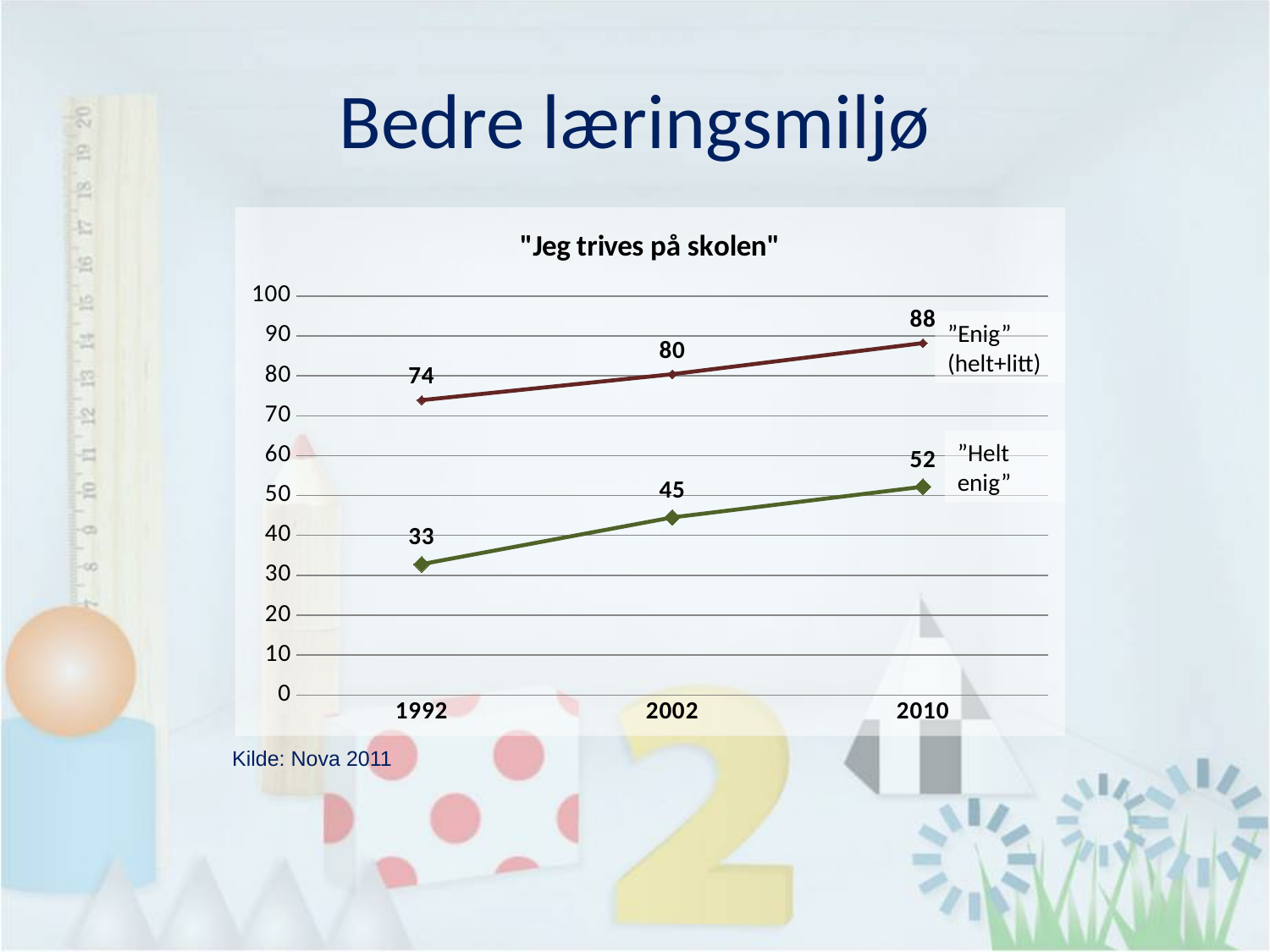
What is the difference between the "Enig" (helt+litt) value and the "Helt enig" value in 2010? 36 In which year is the "Enig" (helt+litt) value lowest? 1992 Which is larger in 2002: the "Enig" (helt+litt) value or the "Helt enig" value? "Enig" (helt+litt) By how much did the "Helt enig" value increase from 1992 to 2010? 19 How many years are shown on the x axis? 3 What is the value for "Helt enig" in 2010? 52 In which year is the "Helt enig" value highest? 2010 What is the value for "Enig" (helt+litt) in 2010? 88 What is the value for "Helt enig" in 1992? 33 What is the value for "Enig" (helt+litt) in 2002? 80 Do the "Helt enig" values rise or fall from 1992 to 2010? Rise What kind of chart is shown on the slide? Line chart